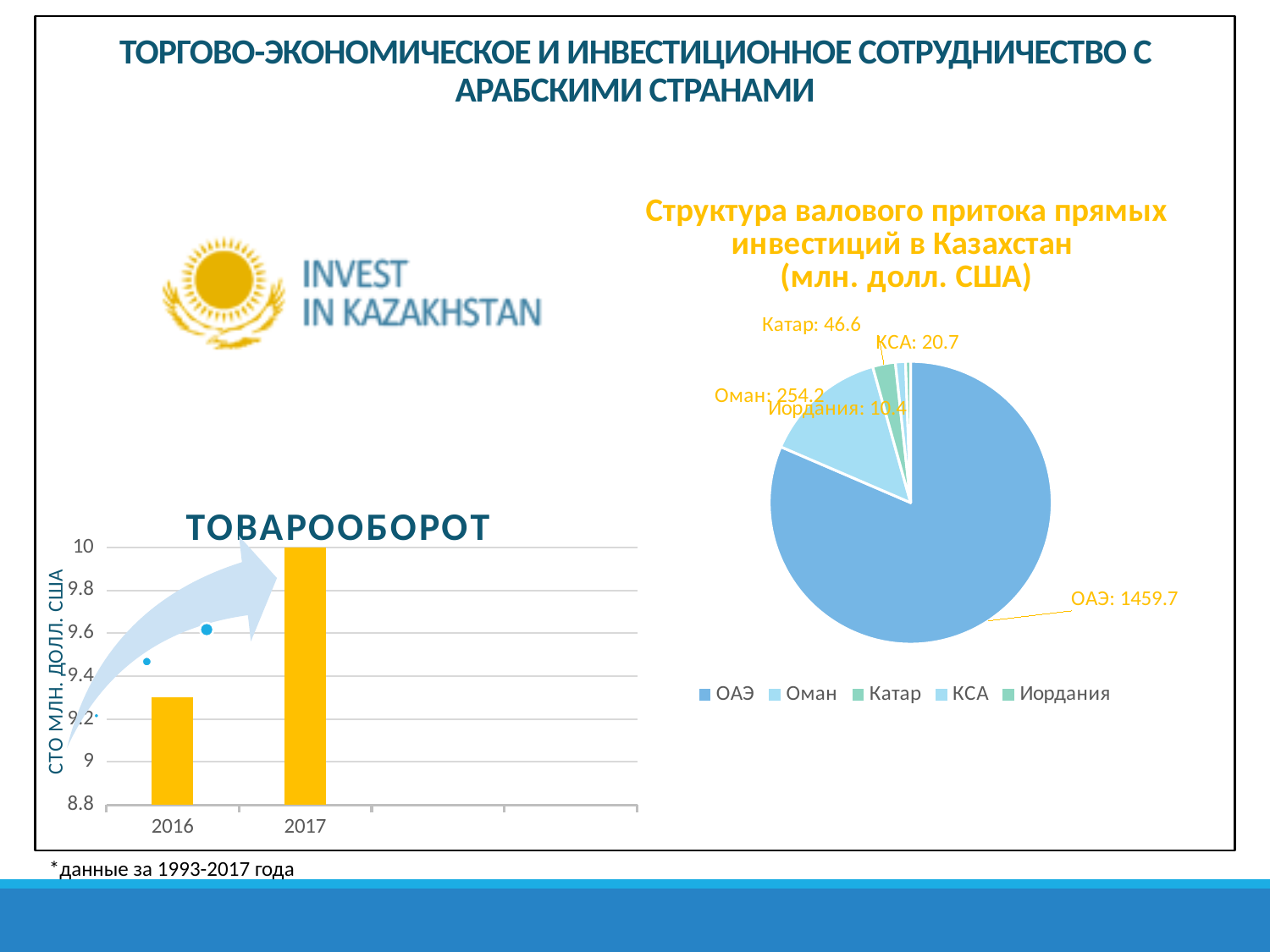
What kind of chart is 'ТОВАРООБОРОТ'? bar chart In the pie chart 'Структура валового притока прямых инвестиций в Казахстан', what is the value for Оман? 254.2 In the pie chart 'Структура валового притока прямых инвестиций в Казахстан', what is the value for Иордания? 10.4 In the pie chart 'Структура валового притока прямых инвестиций в Казахстан', what is the value for Катар? 46.6 In the pie chart 'Структура валового притока прямых инвестиций в Казахстан', what is the difference between the values for Катар and КСА? 25.9 In the pie chart 'Структура валового притока прямых инвестиций в Казахстан', what is the difference between the values for ОАЭ and Оман? 1205.5 In the 'ТОВАРООБОРОТ' chart, which year has the larger value, 2016 or 2017? 2017 In the pie chart 'Структура валового притока прямых инвестиций в Казахстан', what is the value for ОАЭ? 1459.7 In the pie chart 'Структура валового притока прямых инвестиций в Казахстан', which country has the largest slice? ОАЭ In the pie chart 'Структура валового притока прямых инвестиций в Казахстан', how many countries does the legend list? 5 In the 'ТОВАРООБОРОТ' chart, is the value for 2016 greater or less than 9.4? less In the pie chart 'Структура валового притока прямых инвестиций в Казахстан', which country has the smallest slice? Иордания